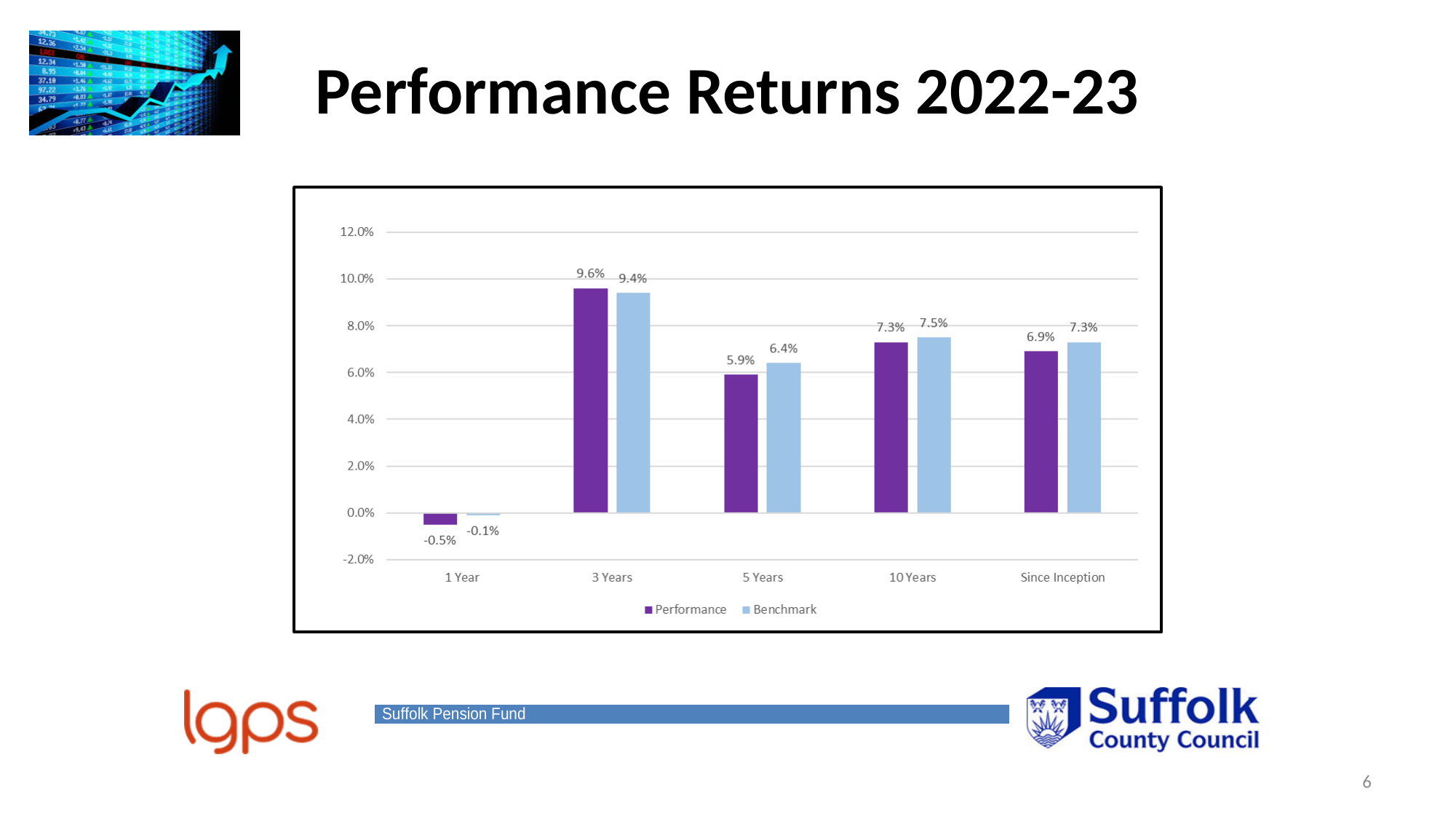
What is the difference between the Benchmark and Performance values for 5 Years? 0.5% What kind of chart is shown on the slide? Bar chart What is the Benchmark value for 5 Years? 6.4% What is the Performance value for 3 Years? 9.6% What is the Performance value for 1 Year? -0.5% Which period has the lowest Benchmark value? 1 Year What is the Benchmark value for Since Inception? 7.3% For 10 Years, which is larger, Performance or Benchmark? Benchmark How many periods are shown on the x axis? 5 Which series is shown in purple? Performance Which period has the highest Performance value? 3 Years How many series does the legend list? 2